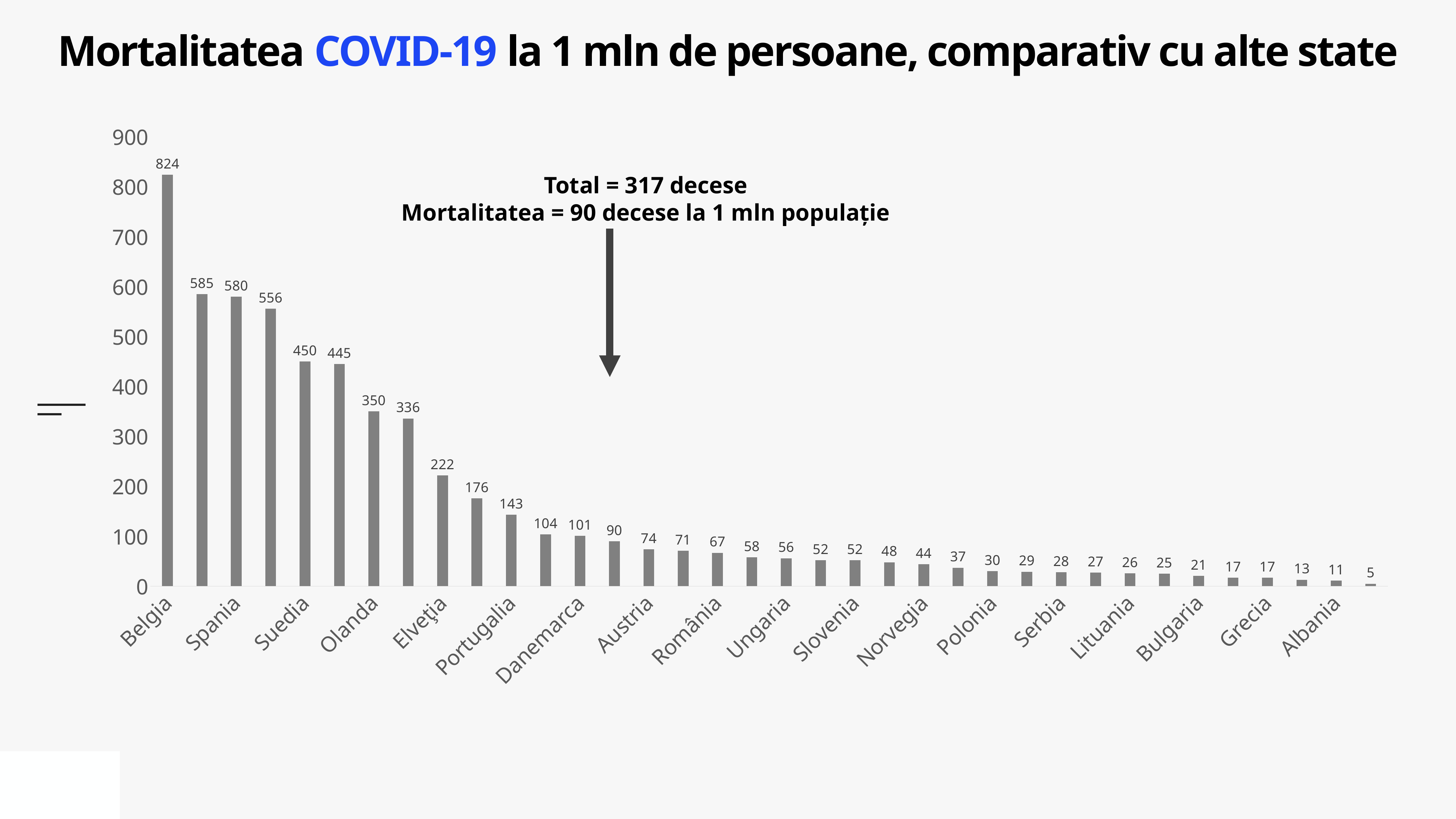
What is the value shown for Olanda? 350 What is the value shown for Portugalia? 143 According to the annotation on the chart, what is the total number of deaths (Total = ... decese)? 317 decese What is the difference between the values for Belgia and Spania? 244 What is the value shown for România? 67 Do the values rise or fall from left to right along the x axis? fall What is the lowest value labelled on the chart? 5 Which has a higher value, Elveția or Danemarca? Elveția What kind of chart is shown on the slide? bar chart What is the value shown for Albania? 11 Which country has the highest COVID-19 mortality per 1 million people on the chart? Belgia What is the value shown for Belgia? 824